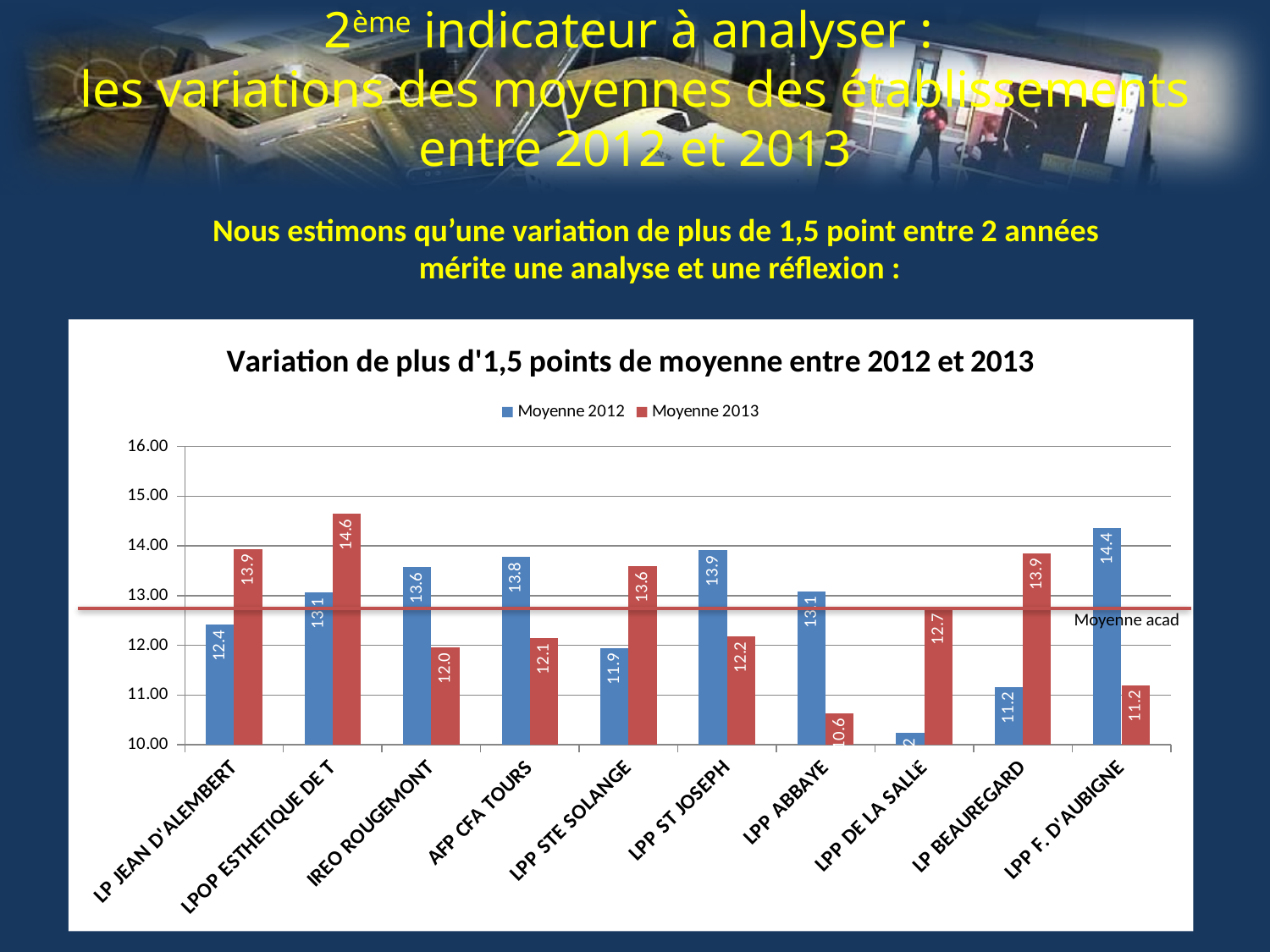
What is the Moyenne 2012 value for AFP CFA TOURS? 13.8 Is the Moyenne 2012 value for LPP DE LA SALLE greater or less than 11.00? less Which establishment has the highest Moyenne 2012 value? LPP F. D'AUBIGNE How many series does the legend list? 2 Which establishment has the highest Moyenne 2013 value? LPOP ESTHETIQUE DE T How many establishments are shown on the x axis? 10 Which establishment has the lowest Moyenne 2013 value? LPP ABBAYE What type of chart is shown on the slide? Bar chart What is the Moyenne 2013 value for LP JEAN D'ALEMBERT? 13.9 What is the Moyenne 2013 value for LPP ABBAYE? 10.6 For IREO ROUGEMONT, which is larger: Moyenne 2012 or Moyenne 2013? Moyenne 2012 What is the difference between the Moyenne 2013 and Moyenne 2012 values for LP BEAUREGARD? 2.7